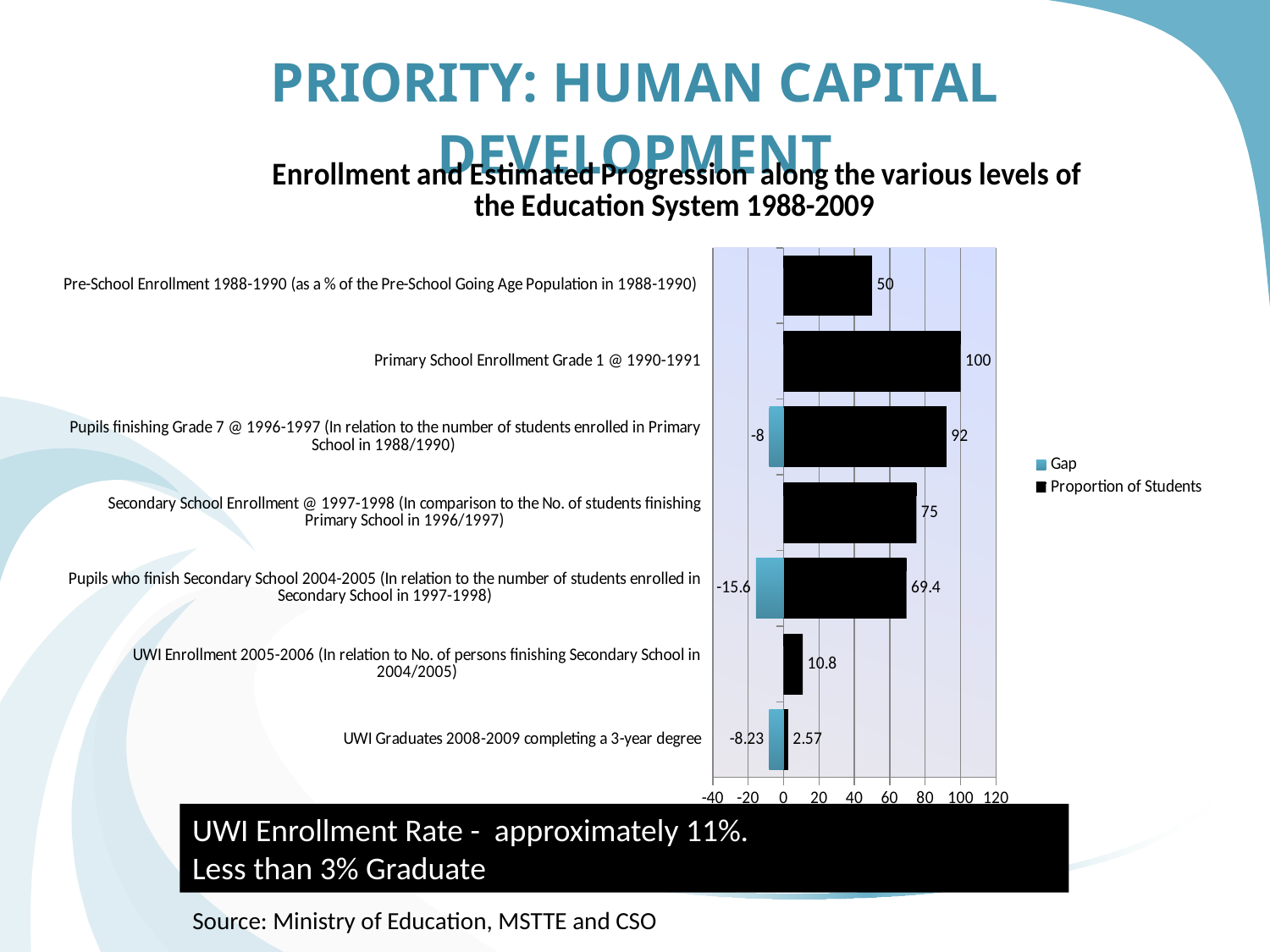
Which category has the highest Proportion of Students value? Primary School Enrollment Grade 1 @ 1990-1991 How many categories are shown on the chart? 7 How many series does the legend list? 2 What kind of chart is shown on the slide? Bar chart What are the two series named in the chart legend? Gap and Proportion of Students What is the Gap value for Pupils who finish Secondary School 2004-2005? -15.6 What is the difference between the Proportion of Students values for Primary School Enrollment Grade 1 and Pupils finishing Grade 7? 8 Which category has the lowest Proportion of Students value? UWI Graduates 2008-2009 completing a 3-year degree What is the Proportion of Students value for Primary School Enrollment Grade 1 @ 1990-1991? 100 What is the Gap value for Pupils finishing Grade 7 @ 1996-1997? -8 Which is larger: the Proportion of Students for Secondary School Enrollment @ 1997-1998 or for Pupils who finish Secondary School 2004-2005? Secondary School Enrollment @ 1997-1998 What is the Proportion of Students value for UWI Graduates 2008-2009 completing a 3-year degree? 2.57